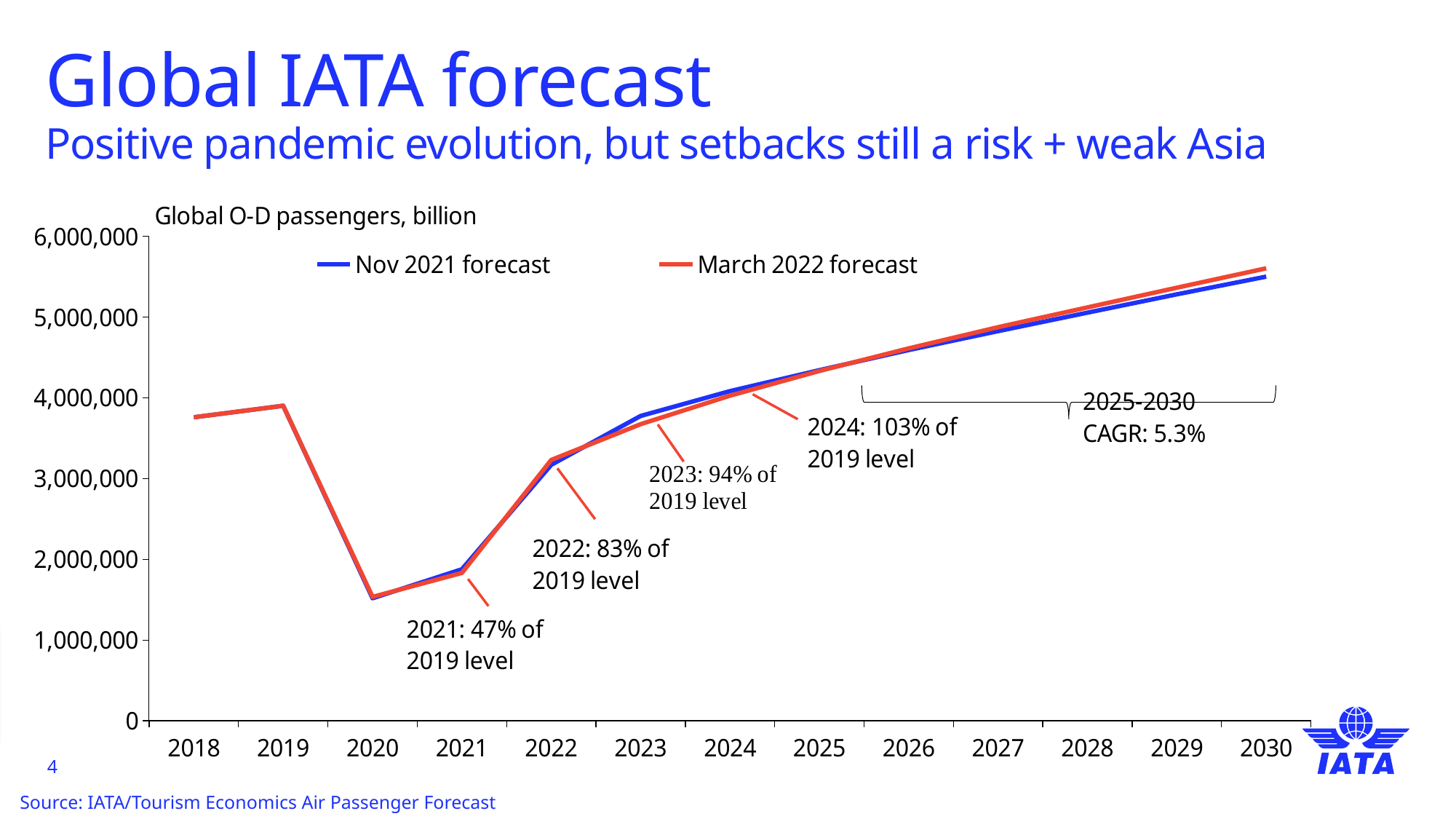
How many years are shown along the x axis of the chart? 13 Is the March 2022 forecast value for 2030 greater or less than 5,000,000? greater Which year has the lowest value for global O-D passengers? 2020 According to the annotation on the chart, what percentage of the 2019 level is reached in 2021? 47% Is the value for 2018 greater or less than 3,000,000? greater How many series does the chart legend list? 2 What kind of chart is shown on the slide? line chart Which is larger, the value for 2018 or the value for 2022? 2018 Do the values rise or fall from 2020 to 2030? rise Which year has the highest value for global O-D passengers? 2030 What CAGR does the chart annotation give for 2025-2030? 5.3% Is the value for 2020 greater or less than 2,000,000? less